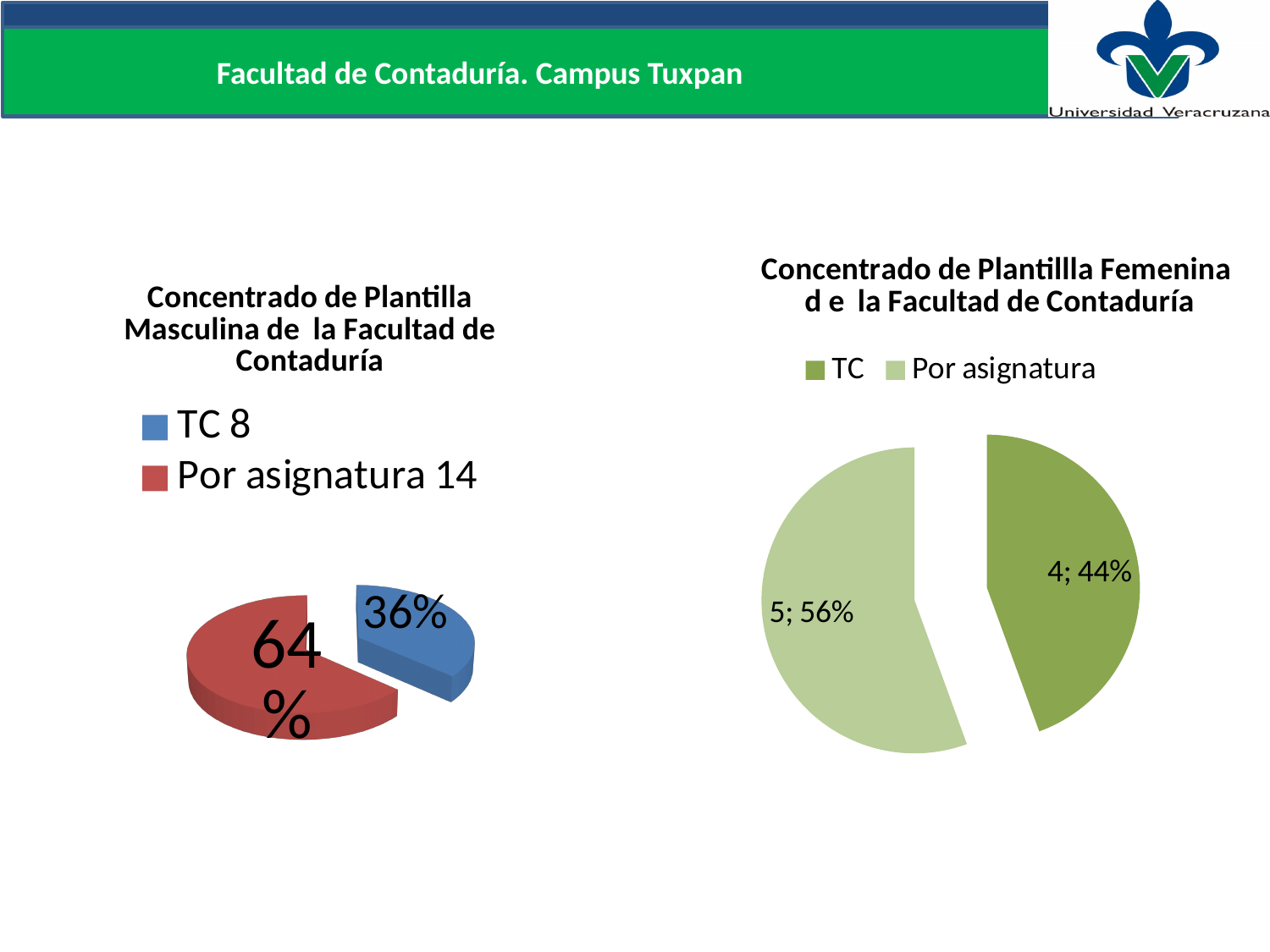
In the right chart (Concentrado de Plantillla Femenina), what value and share are shown for Por asignatura? 5; 56% What type of chart is the right chart (Concentrado de Plantillla Femenina)? Pie chart In the right chart (Concentrado de Plantillla Femenina), which category has the smaller slice? TC In the left chart (Concentrado de Plantilla Masculina), what is the difference between the Por asignatura count and the TC count? 6 In the left chart (Concentrado de Plantilla Masculina), what count is shown for TC in the legend? 8 In the left chart (Concentrado de Plantilla Masculina), what percentage share does the Por asignatura slice have? 64% In the right chart (Concentrado de Plantillla Femenina), what value and share are shown for TC? 4; 44% How many series does the legend of the right chart (Concentrado de Plantillla Femenina) list? 2 In the right chart (Concentrado de Plantillla Femenina), what is the total of the two slice values? 9 In the left chart (Concentrado de Plantilla Masculina), what percentage share does the TC slice have? 36% In the left chart (Concentrado de Plantilla Masculina), what count is shown for Por asignatura in the legend? 14 In the left chart (Concentrado de Plantilla Masculina), which category has the larger slice? Por asignatura